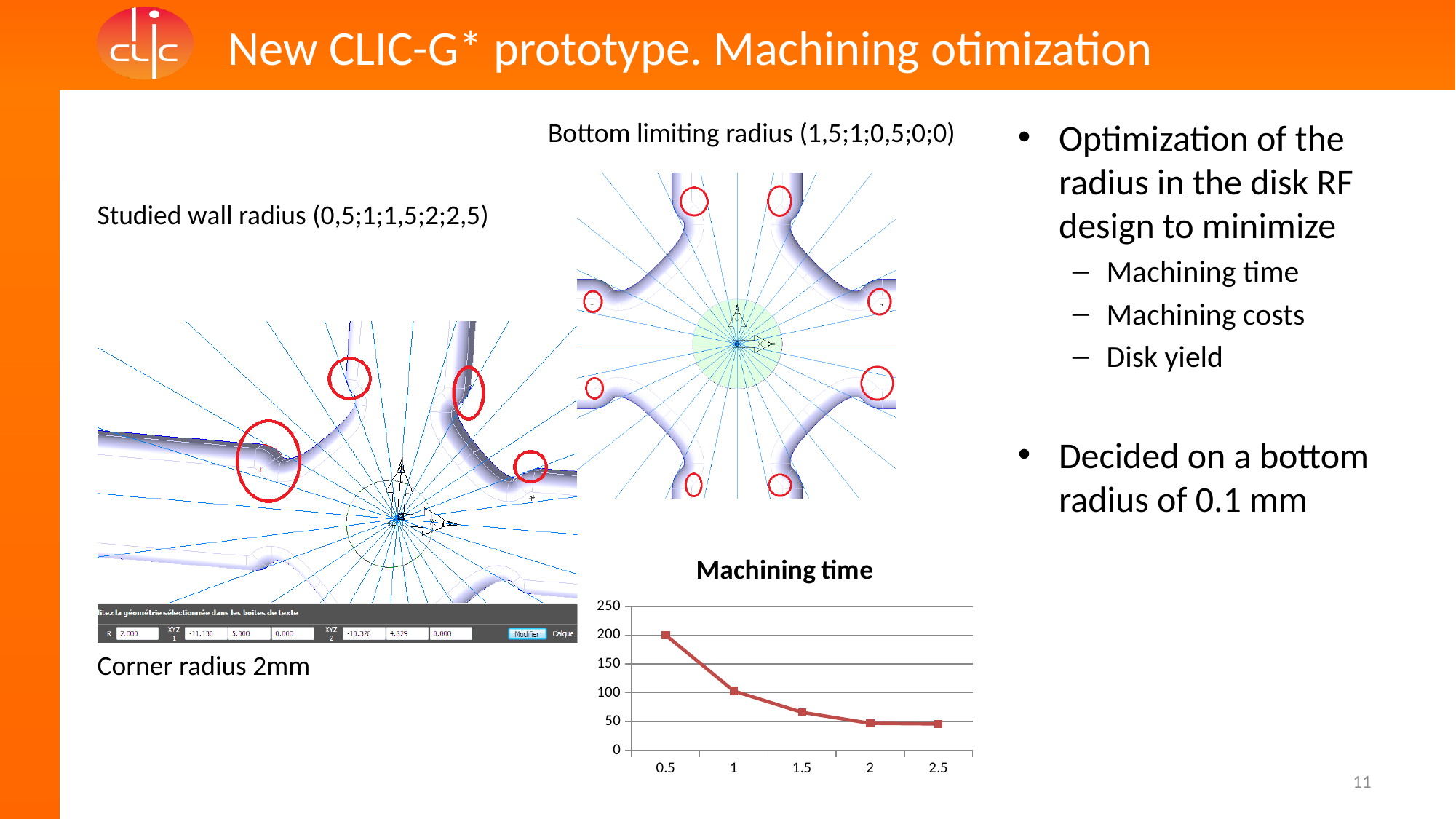
In the Machining time chart, is the value at x = 0.5 greater or less than 150? greater In the Machining time chart, which has the larger value: x = 0.5 or x = 2? 0.5 In the Machining time chart, is the value at x = 1.5 greater or less than 100? less In the Machining time chart, do the values rise or fall as the x-axis value increases from 0.5 to 2.5? fall In the Machining time chart, is the value at x = 2 greater or less than 100? less How many data points are plotted in the Machining time chart? 5 What is the title of the chart on the slide? Machining time What kind of chart is the Machining time chart? line chart In the Machining time chart, which x-axis value has the highest machining time? 0.5 In the Machining time chart, which has the larger value: x = 1 or x = 1.5? 1